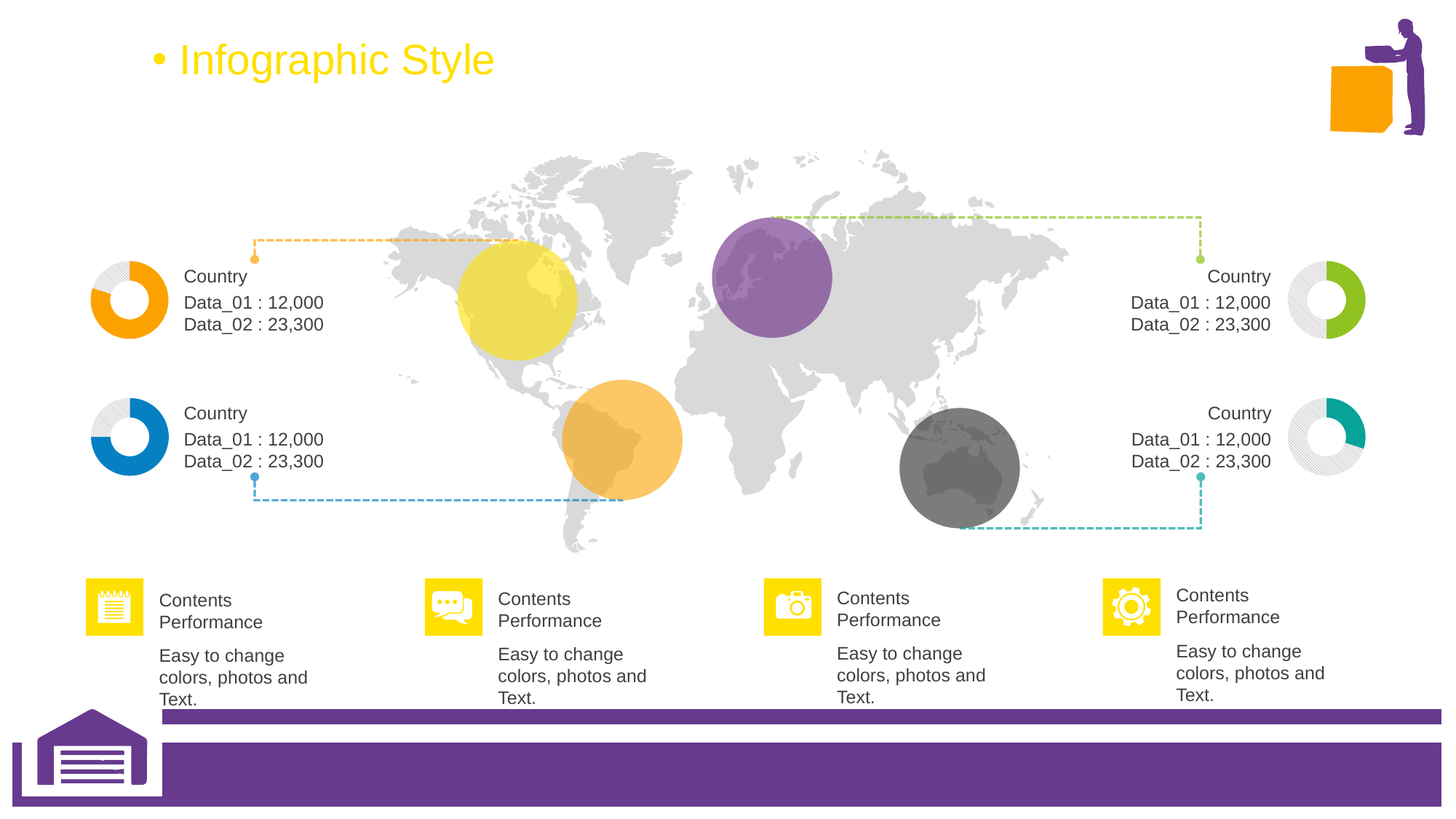
What colour is the donut chart at the bottom right of the slide? teal How many donut charts are on the slide? 4 What label appears above the data values next to each donut chart? Country For the green donut chart at the top right, what is the value of Data_01? 12,000 What kind of chart are the four small charts beside the world map? donut chart For the green donut chart at the top right, is Data_01 greater or less than Data_02? less For the orange donut chart at the top left, what is the value of Data_01? 12,000 For the blue donut chart at the bottom left, which is larger, Data_01 or Data_02? Data_02 For the teal donut chart at the bottom right, what is the value of Data_02? 23,300 For the orange donut chart at the top left, what is the difference between Data_02 and Data_01? 11,300 For the blue donut chart at the bottom left, what is the value of Data_02? 23,300